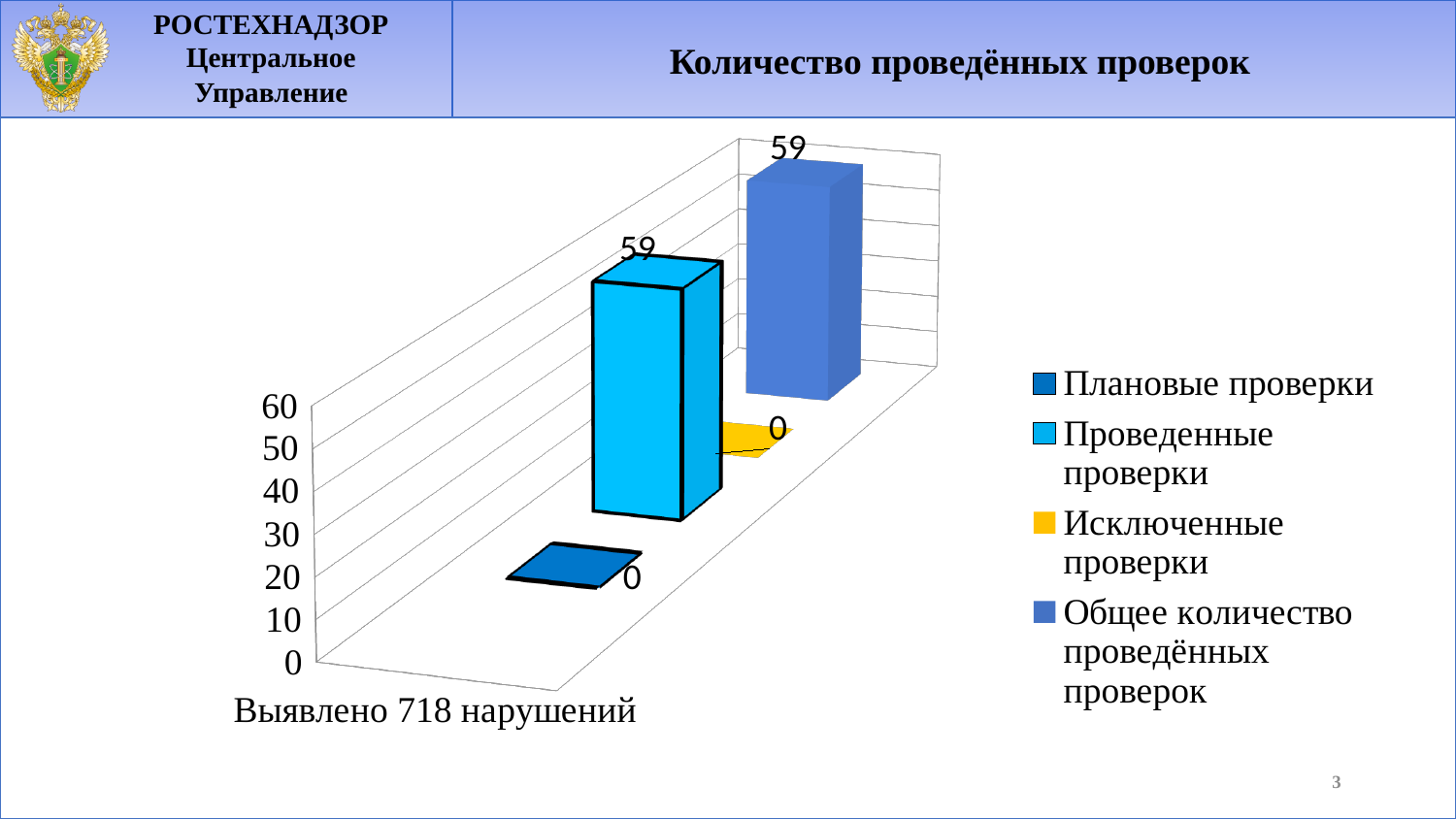
How many series does the legend list? 4 What is the value for Общее количество проведённых проверок? 59 What is the highest value shown on the vertical axis? 60 What is the value for Исключенные проверки? 0 What is the title of the chart? Количество проведённых проверок Is the value for Общее количество проведённых проверок greater or less than 50? greater What is the value for Проведенные проверки? 59 What is the label shown on the category axis of the chart? Выявлено 718 нарушений What kind of chart is shown on the slide? bar chart What is the value for Плановые проверки? 0 What is the difference between Проведенные проверки and Плановые проверки? 59 Which is larger, Проведенные проверки or Исключенные проверки? Проведенные проверки